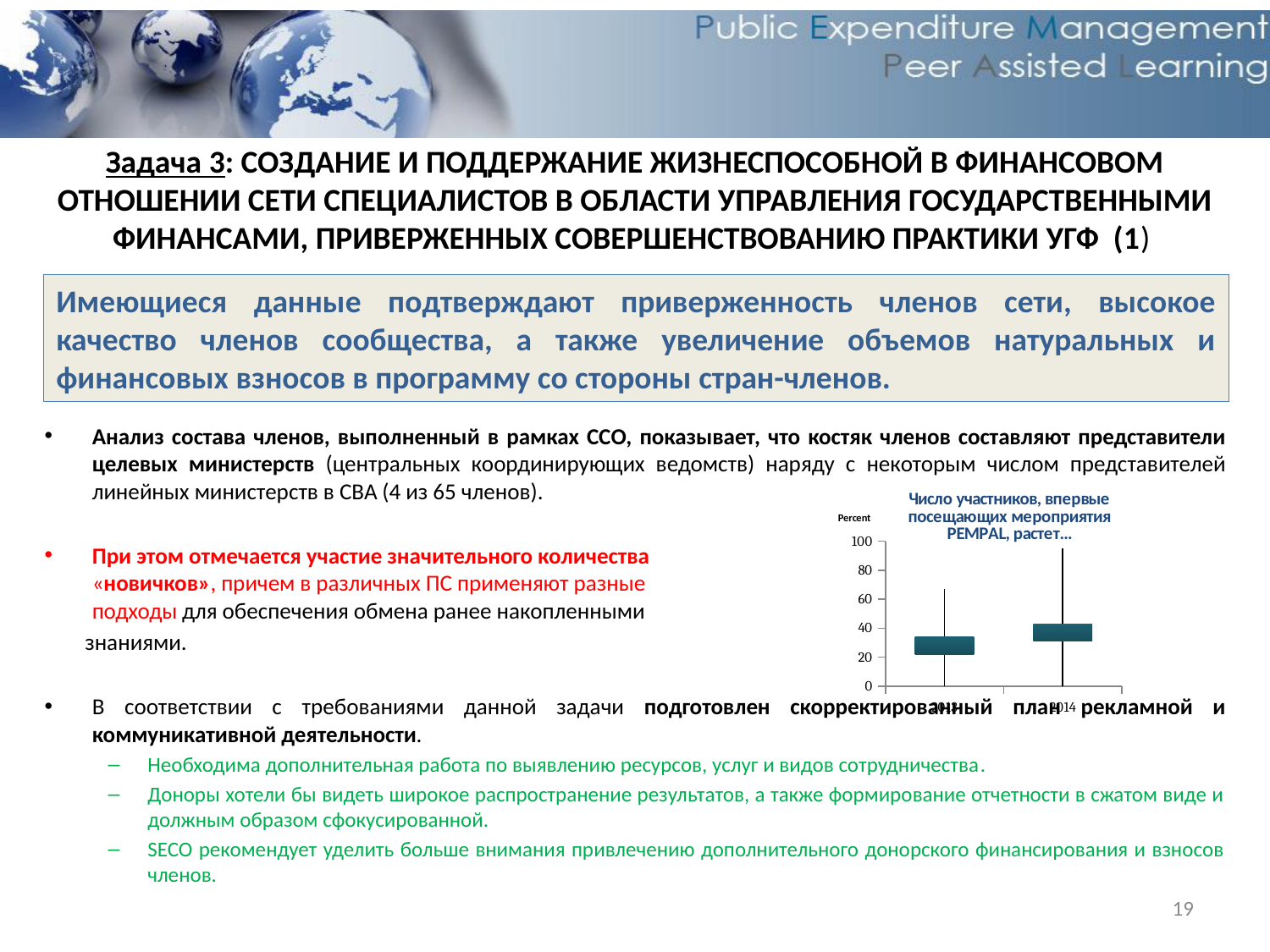
Which year has the higher box in the chart, 2013 or 2014? 2014 Is the top of the upper whisker for 2014 greater or less than 80? greater What is the label on the vertical axis of the chart? Percent What is the highest tick value shown on the vertical axis of the chart? 100 Is the top of the box for 2013 greater or less than 40? less How many categories (years) are plotted on the x axis of the chart? 2 Which year has the longer upper whisker in the chart? 2014 What is the title of the chart on the slide? Число участников, впервые посещающих мероприятия PEMPAL, растет… Does the plotted value rise or fall from 2013 to 2014 in the chart? rise Is the top of the upper whisker for 2013 greater or less than 80? less